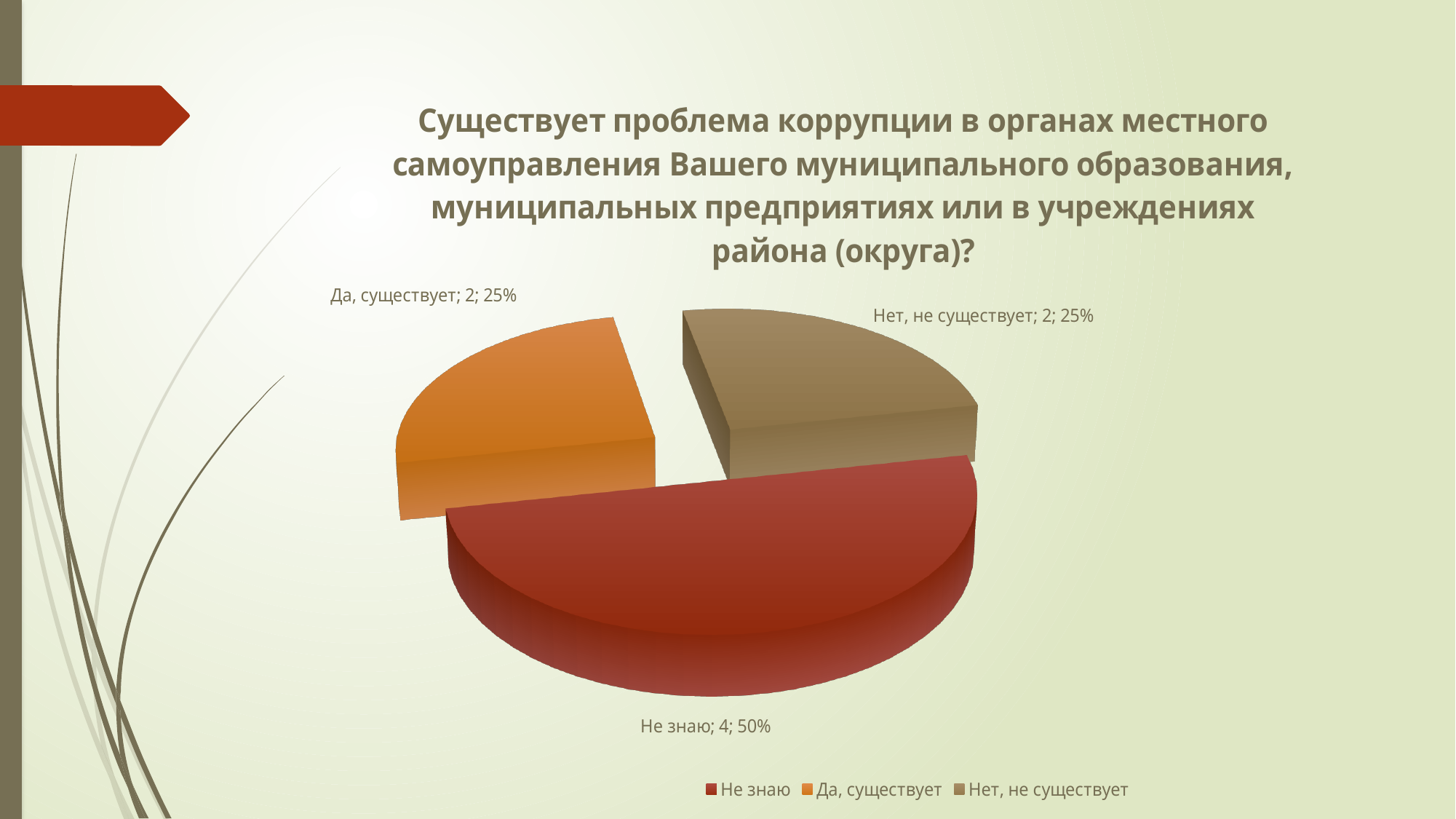
What share of the pie does "Не знаю" represent? 50% What is the value for "Не знаю"? 4 What colour is the "Не знаю" slice? red How many slices does the pie chart have? 3 What is the value for "Нет, не существует"? 2 What is the difference between the values for "Не знаю" and "Нет, не существует"? 2 What is the value for "Да, существует"? 2 Which category has the largest slice? Не знаю What share of the pie does "Да, существует" represent? 25% How many entries does the legend list? 3 Which is larger, the value for "Не знаю" or the value for "Да, существует"? Не знаю What kind of chart is shown on the slide? pie chart